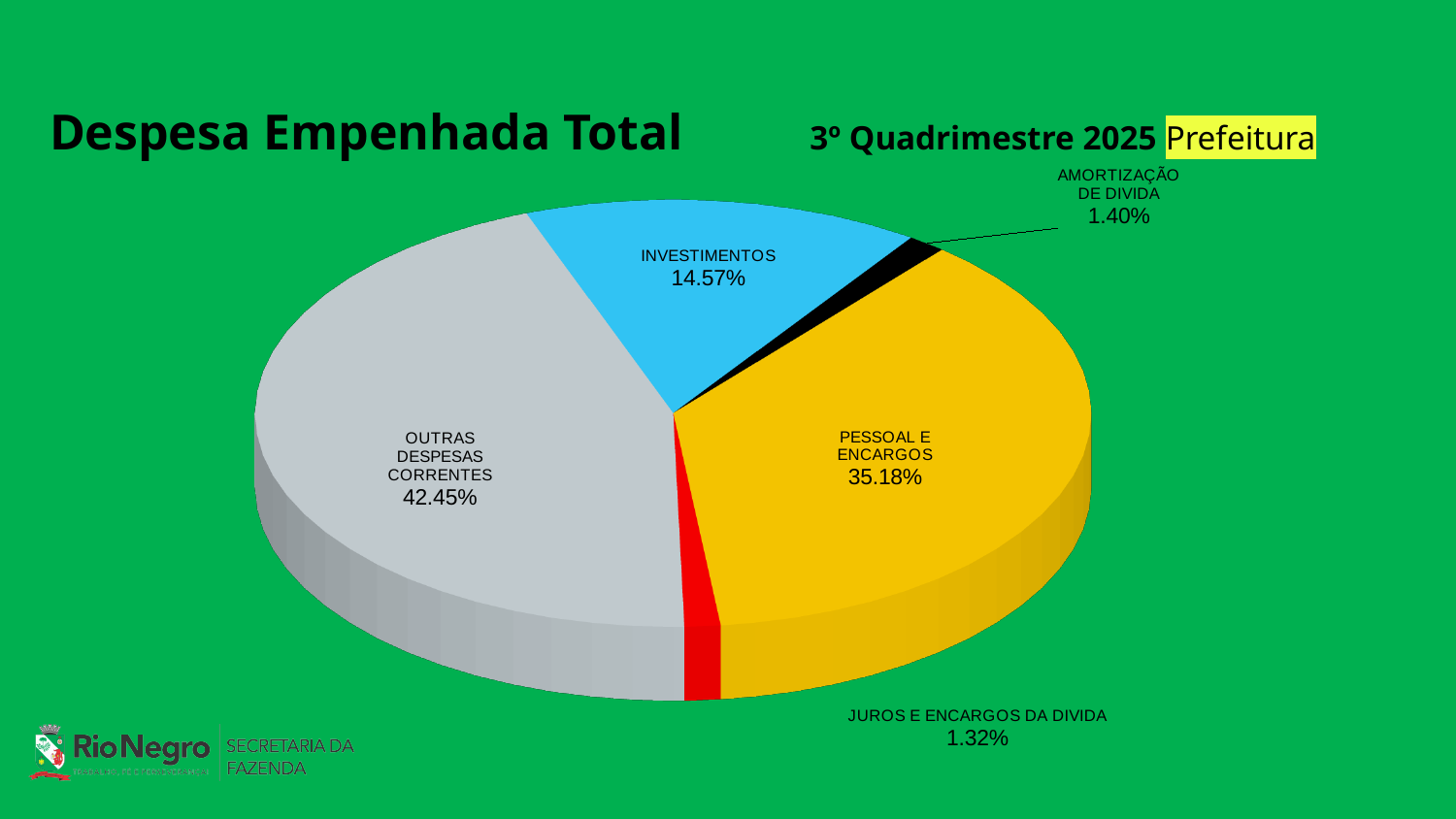
Which category has the smallest slice of the pie? JUROS E ENCARGOS DA DIVIDA What share of the pie does OUTRAS DESPESAS CORRENTES represent? 42.45% What is the value labelled for INVESTIMENTOS? 14.57% How many categories are shown in the pie chart? 5 What type of chart is shown on the slide? Pie chart Which category has the largest slice of the pie? OUTRAS DESPESAS CORRENTES Which is larger, INVESTIMENTOS or PESSOAL E ENCARGOS? PESSOAL E ENCARGOS What percentage is shown for AMORTIZAÇÃO DE DIVIDA? 1.40% What percentage is shown for PESSOAL E ENCARGOS? 35.18% How many percentage points larger is OUTRAS DESPESAS CORRENTES than PESSOAL E ENCARGOS? 7.27 What percentage is shown for JUROS E ENCARGOS DA DIVIDA? 1.32% What is the difference in percentage points between PESSOAL E ENCARGOS and INVESTIMENTOS? 20.61